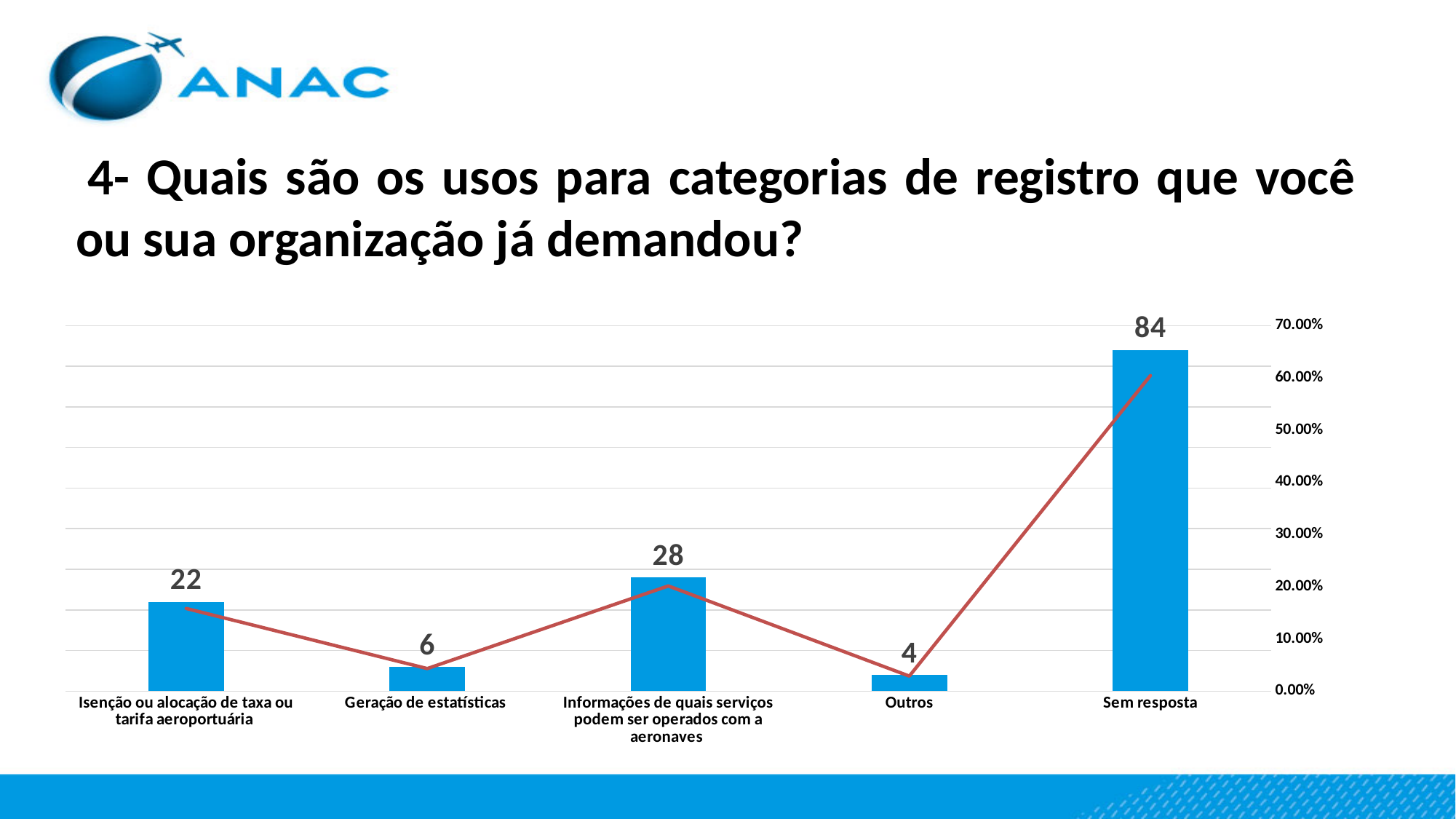
Is the red line's value for "Outros" greater or less than 10.00%? less Which category has the lowest bar? Outros What colour are the bars in the chart? Blue What is the difference between the bar values for "Isenção ou alocação de taxa ou tarifa aeroportuária" and "Geração de estatísticas"? 16 Which category has the highest bar? Sem resposta Is the red line's value for "Sem resposta" greater or less than 50.00%? greater What is the value of the bar for "Geração de estatísticas"? 6 What is the value of the bar for "Sem resposta"? 84 What is the value of the bar for "Informações de quais serviços podem ser operados com a aeronaves"? 28 Which bar is larger: "Isenção ou alocação de taxa ou tarifa aeroportuária" or "Informações de quais serviços podem ser operados com a aeronaves"? Informações de quais serviços podem ser operados com a aeronaves How many categories are shown on the x axis? 5 What is the difference between the bar values for "Sem resposta" and "Informações de quais serviços podem ser operados com a aeronaves"? 56